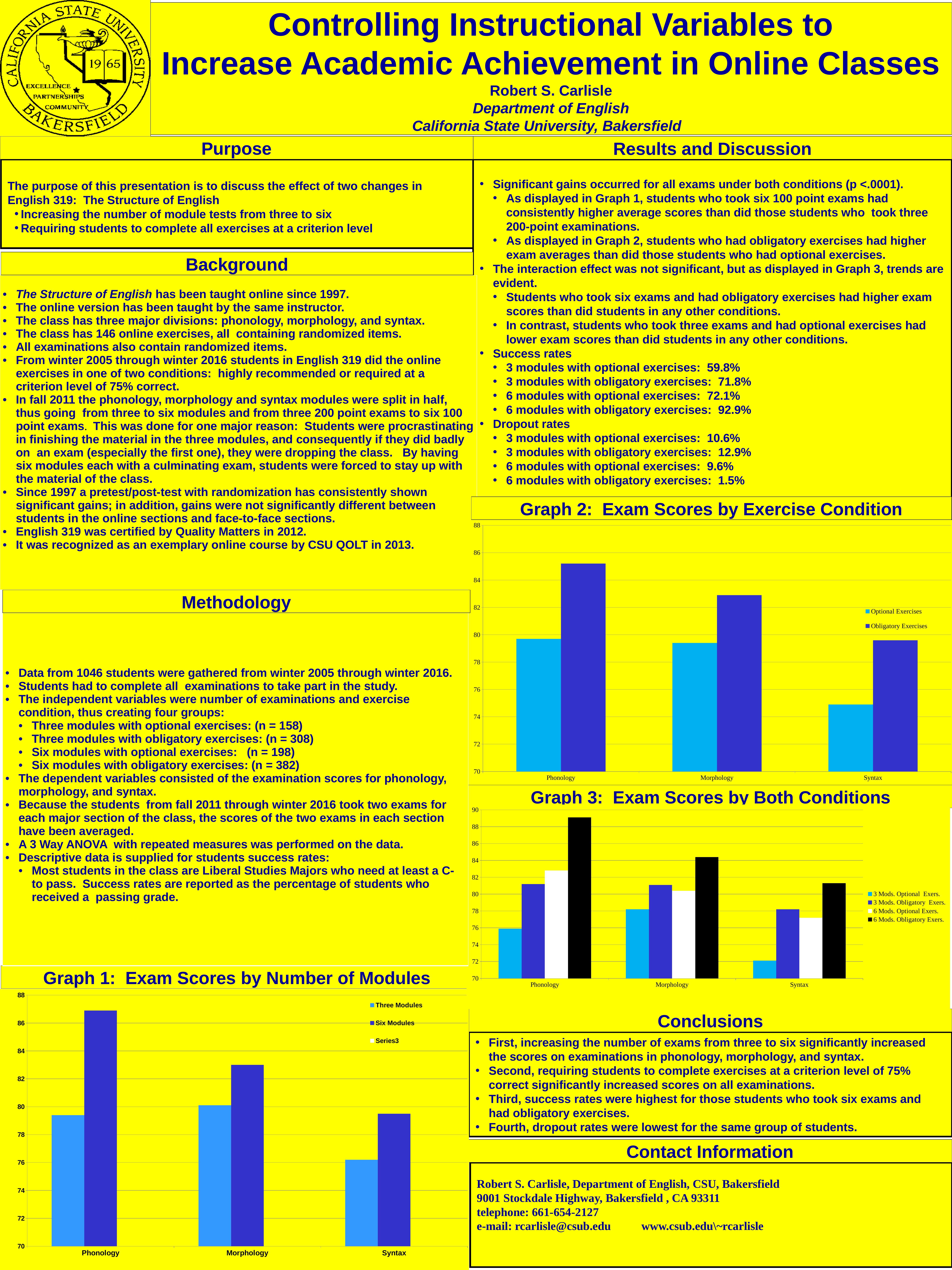
In Graph 1: Exam Scores by Number of Modules, which category has the lowest Three Modules score? Syntax In Graph 1: Exam Scores by Number of Modules, how many categories are shown on the x axis? 3 What kind of chart is Graph 1: Exam Scores by Number of Modules? bar chart In Graph 2: Exam Scores by Exercise Condition, which category has the highest Obligatory Exercises score? Phonology In Graph 3: Exam Scores by Both Conditions, which category has the highest 6 Mods. Obligatory Exers. score? Phonology In Graph 3: Exam Scores by Both Conditions, is the 3 Mods. Optional Exers. value for Syntax greater or less than 74? less In Graph 2: Exam Scores by Exercise Condition, how many series does the legend list? 2 In Graph 2: Exam Scores by Exercise Condition, is the Optional Exercises value for Syntax greater or less than 76? less In Graph 1: Exam Scores by Number of Modules, which is larger for Morphology, Three Modules or Six Modules? Six Modules In Graph 1: Exam Scores by Number of Modules, is the Six Modules value for Phonology greater or less than 86? greater In Graph 1: Exam Scores by Number of Modules, how many entries does the legend list? 3 In Graph 3: Exam Scores by Both Conditions, how many series does the legend list? 4